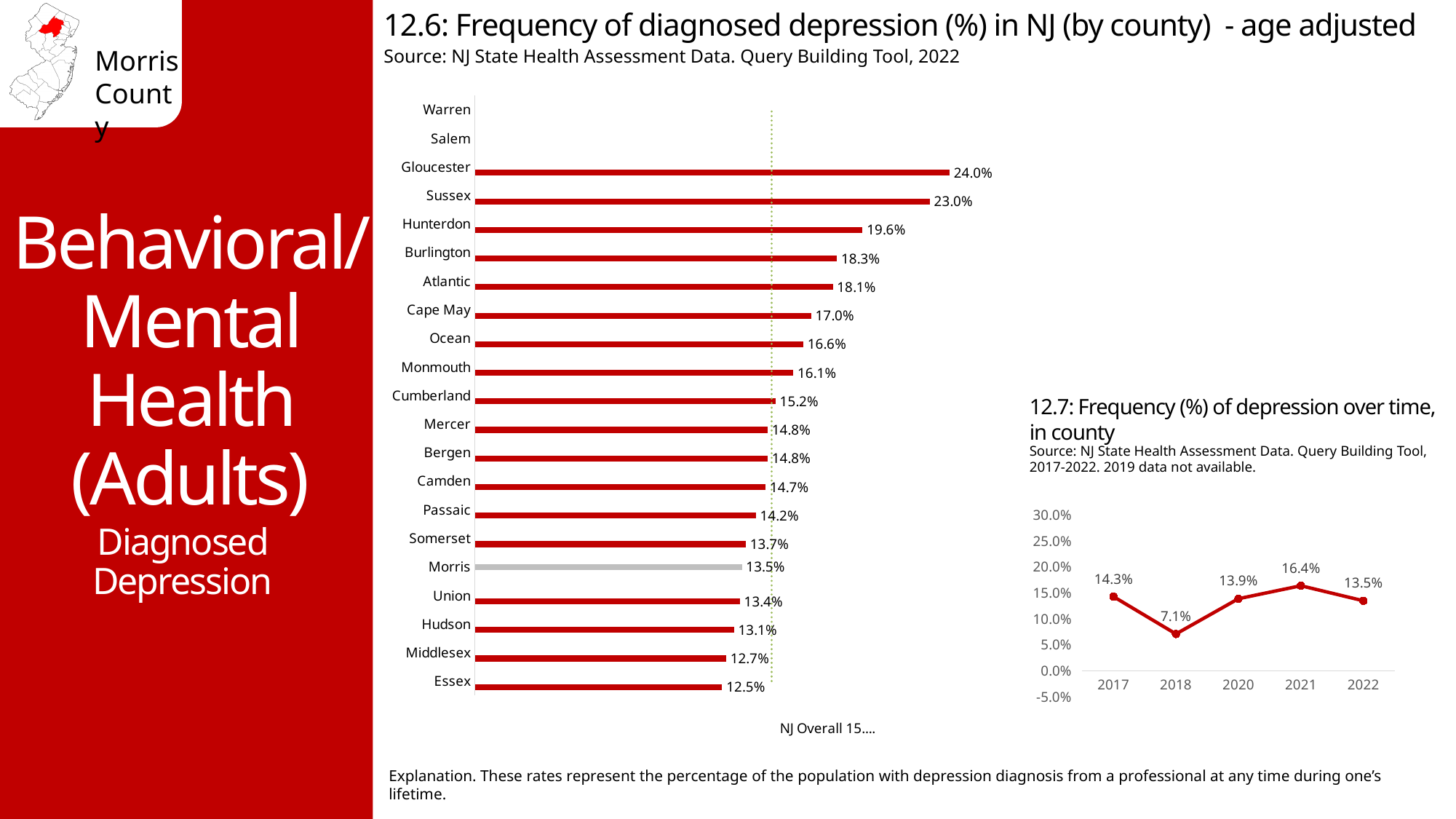
In chart 12.6, which county with a plotted bar has the lowest frequency of diagnosed depression? Essex In chart 12.6, what is the value shown for Morris? 13.5% In chart 12.7, which year has the highest frequency of depression? 2021 In chart 12.6, what is the difference between the values for Sussex and Hunterdon? 3.4% In chart 12.7, what is the difference between the 2021 and 2022 values? 2.9% What kind of chart is chart 12.6? Bar chart In chart 12.6, which county has the highest frequency of diagnosed depression? Gloucester In chart 12.6, what is the frequency of diagnosed depression for Gloucester? 24.0% In chart 12.6, which county has a higher value, Burlington or Cape May? Burlington In chart 12.7, what is the frequency of depression in 2018? 7.1% In chart 12.7, how many data points are plotted? 5 What kind of chart is chart 12.7? Line chart